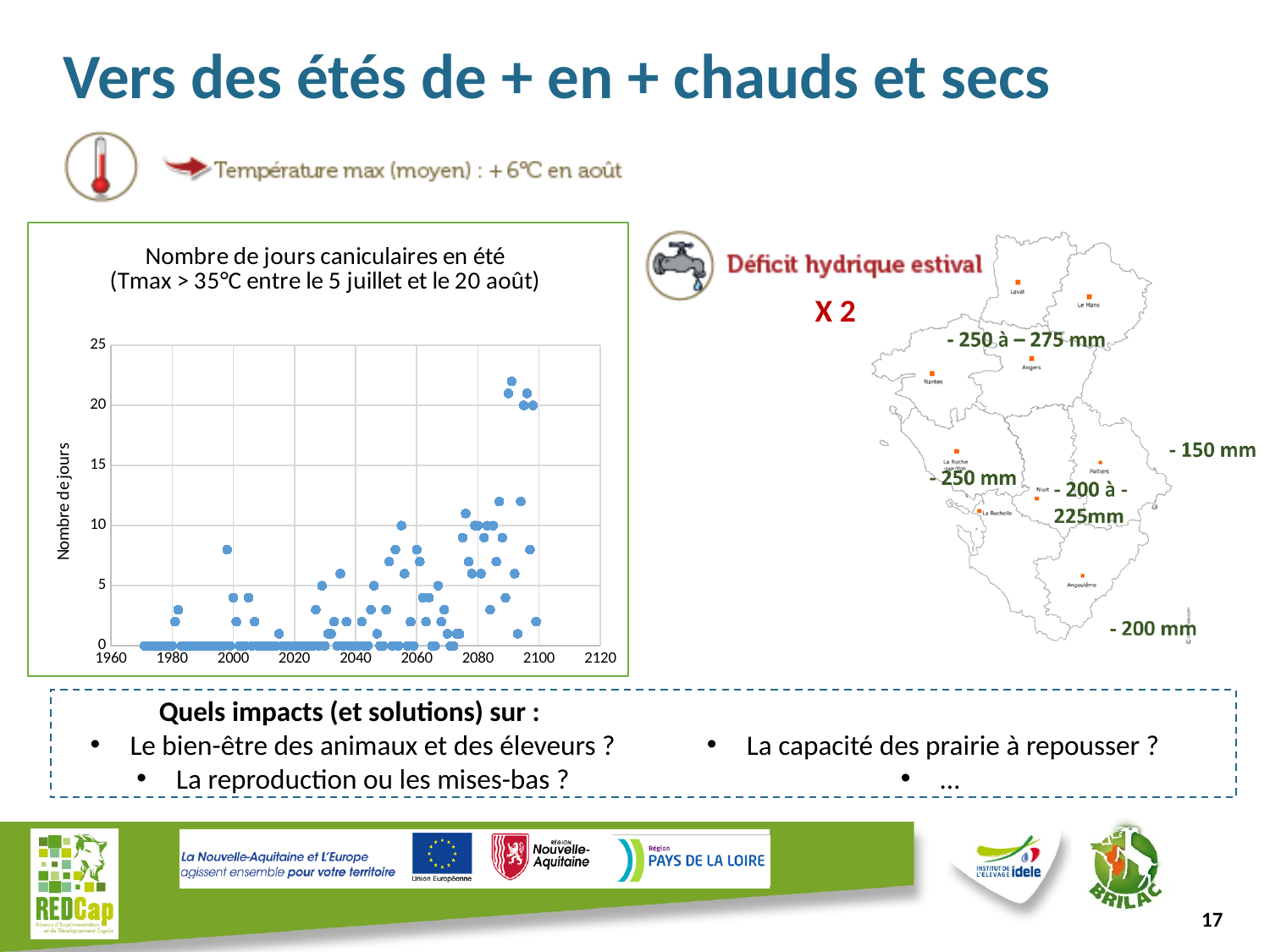
Do the values in the scatter chart generally rise or fall as the years increase along the x axis? rise What kind of chart is shown on the left of the slide? scatter chart Is the highest value plotted in the scatter chart greater or less than 25? less What is the maximum value shown on the y axis of the scatter chart? 25 Is the highest value plotted in the scatter chart greater or less than 20? greater What is the label of the y axis of the scatter chart? Nombre de jours What is the title of the chart on the left of the slide? Nombre de jours caniculaires en été (Tmax > 35°C entre le 5 juillet et le 20 août)